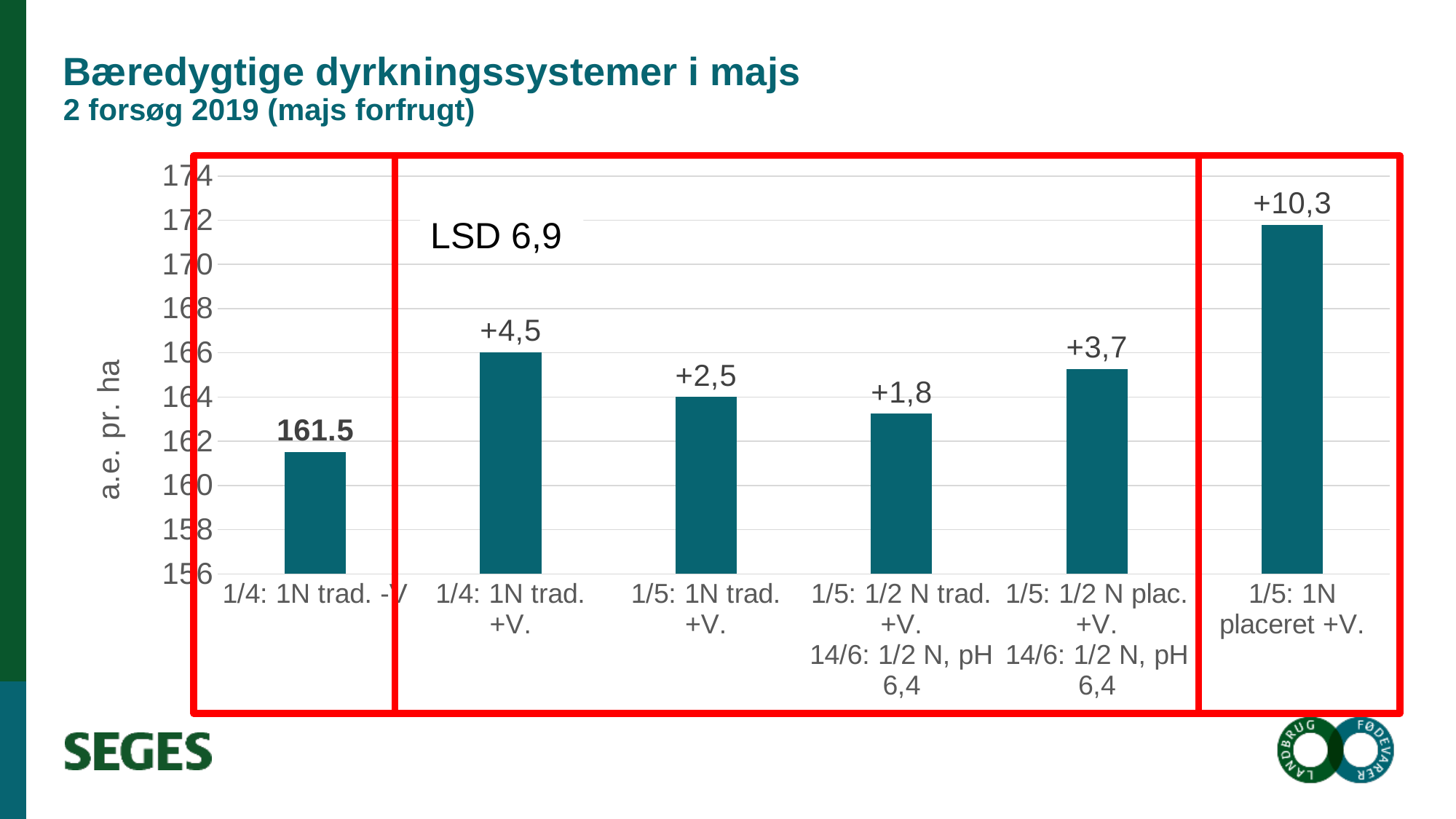
How many bars are shown in the chart? 6 Which category has the tallest bar? 1/5: 1N placeret +V. What data label is shown on the bar for "1/4: 1N trad. +V."? +4,5 Which category has the shortest bar? 1/4: 1N trad. -V What kind of chart is shown on the slide? bar chart Is the value for "1/5: 1N placeret +V." greater or less than 170? greater What data label is shown on the bar for "1/5: 1N placeret +V."? +10,3 Which bar is taller: "1/5: 1/2 N trad. +V. 14/6: 1/2 N, pH 6,4" or "1/5: 1/2 N plac. +V. 14/6: 1/2 N, pH 6,4"? 1/5: 1/2 N plac. +V. 14/6: 1/2 N, pH 6,4 What data label is shown on the bar for "1/4: 1N trad. -V"? 161.5 What is the label on the vertical axis of the chart? a.e. pr. ha What data label is shown on the bar for "1/5: 1N trad. +V."? +2,5 Is the value for "1/4: 1N trad. -V" greater or less than 160? greater